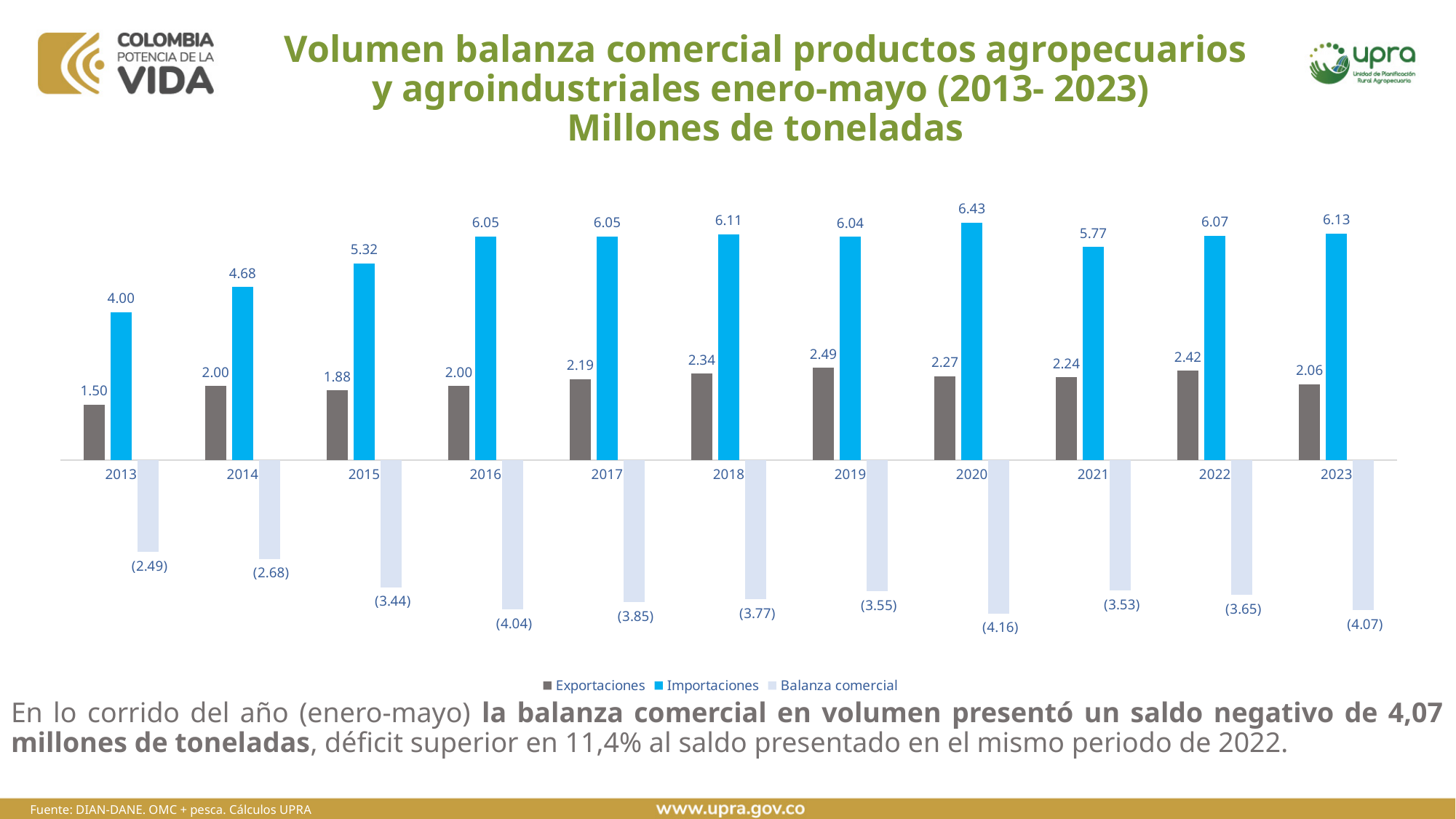
In which year are Exportaciones highest? 2019 What is the difference between Importaciones and Exportaciones in 2023? 4.07 In which year are Importaciones lowest? 2013 What is the value of Importaciones for 2020? 6.43 What is the value of Exportaciones for 2013? 1.50 How many years are shown on the x axis? 11 What is the Balanza comercial value shown for 2023? (4.07) Which is larger, Exportaciones in 2018 or Exportaciones in 2022? 2022 What is the difference between Importaciones in 2020 and in 2021? 0.66 How many series does the legend list? 3 In which year are Importaciones highest? 2020 What kind of chart is shown on the slide? Bar chart